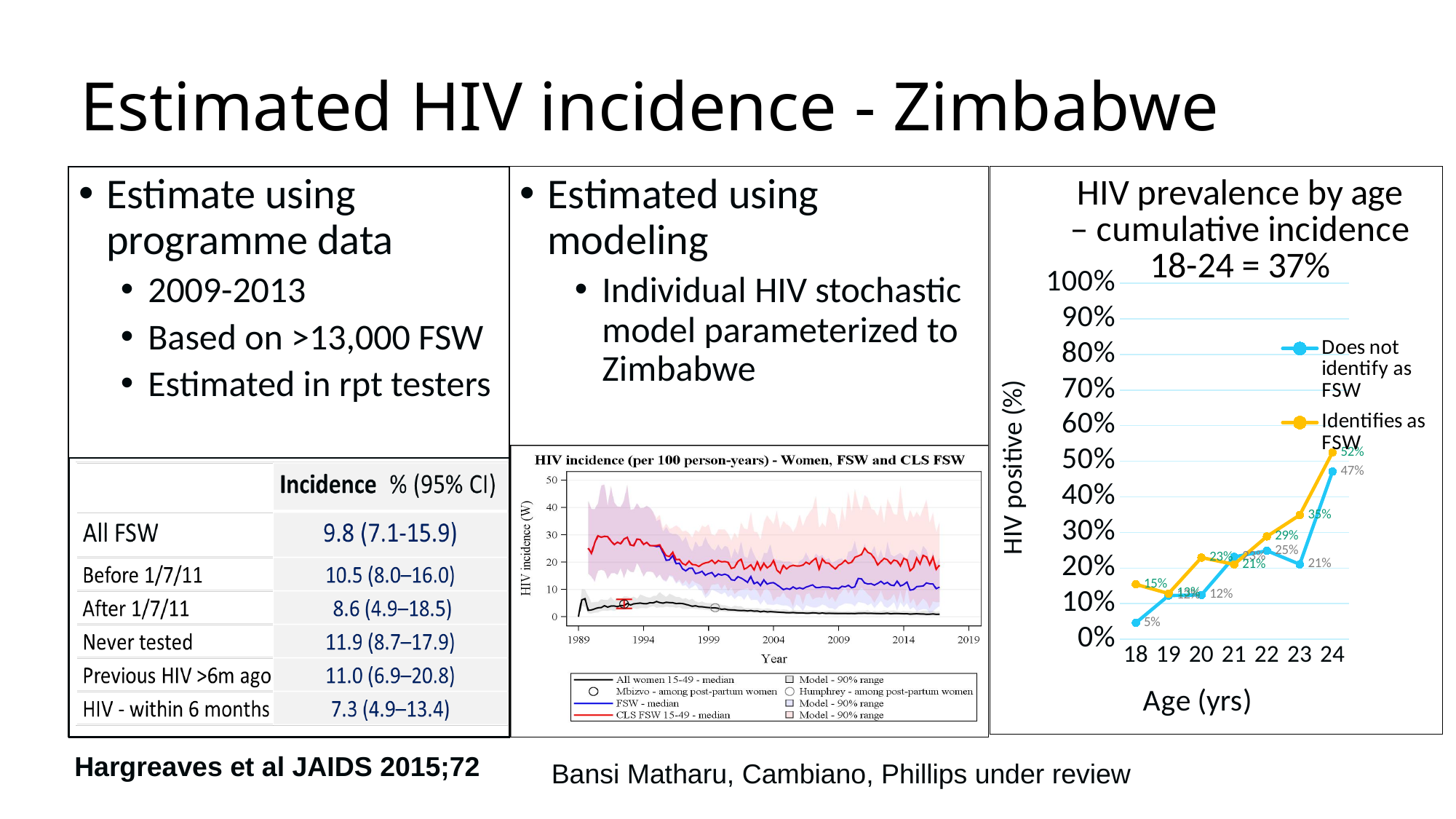
In the 'HIV prevalence by age' chart on the right, what is the value for 'Does not identify as FSW' at age 18? 5% In the 'HIV prevalence by age' chart on the right, what is the difference between the 'Identifies as FSW' and 'Does not identify as FSW' values at age 24? 5 percentage points In the 'HIV prevalence by age' chart on the right, which series has the higher value at age 23? Identifies as FSW What kind of chart is the 'HIV incidence (per 100 person-years)' chart in the middle of the slide? Line chart In the 'HIV incidence (per 100 person-years)' chart in the middle, does the 'CLS FSW 15-49 - median' line rise or fall from 1989 to 2019? Fall How many age categories are shown on the x axis of the 'HIV prevalence by age' chart on the right? 7 In the 'HIV prevalence by age' chart on the right, what is the value for 'Identifies as FSW' at age 24? 52% In the 'HIV incidence (per 100 person-years)' chart in the middle, is the 'All women 15-49 - median' value in 2014 greater or less than 10? less In the 'HIV prevalence by age' chart on the right, at which age is the 'Does not identify as FSW' series highest? 24 In the 'HIV prevalence by age' chart on the right, what is the value for 'Does not identify as FSW' at age 24? 47% In the 'HIV prevalence by age' chart on the right, what is the value for 'Identifies as FSW' at age 18? 15% How many series does the legend of the 'HIV prevalence by age' chart on the right list? 2